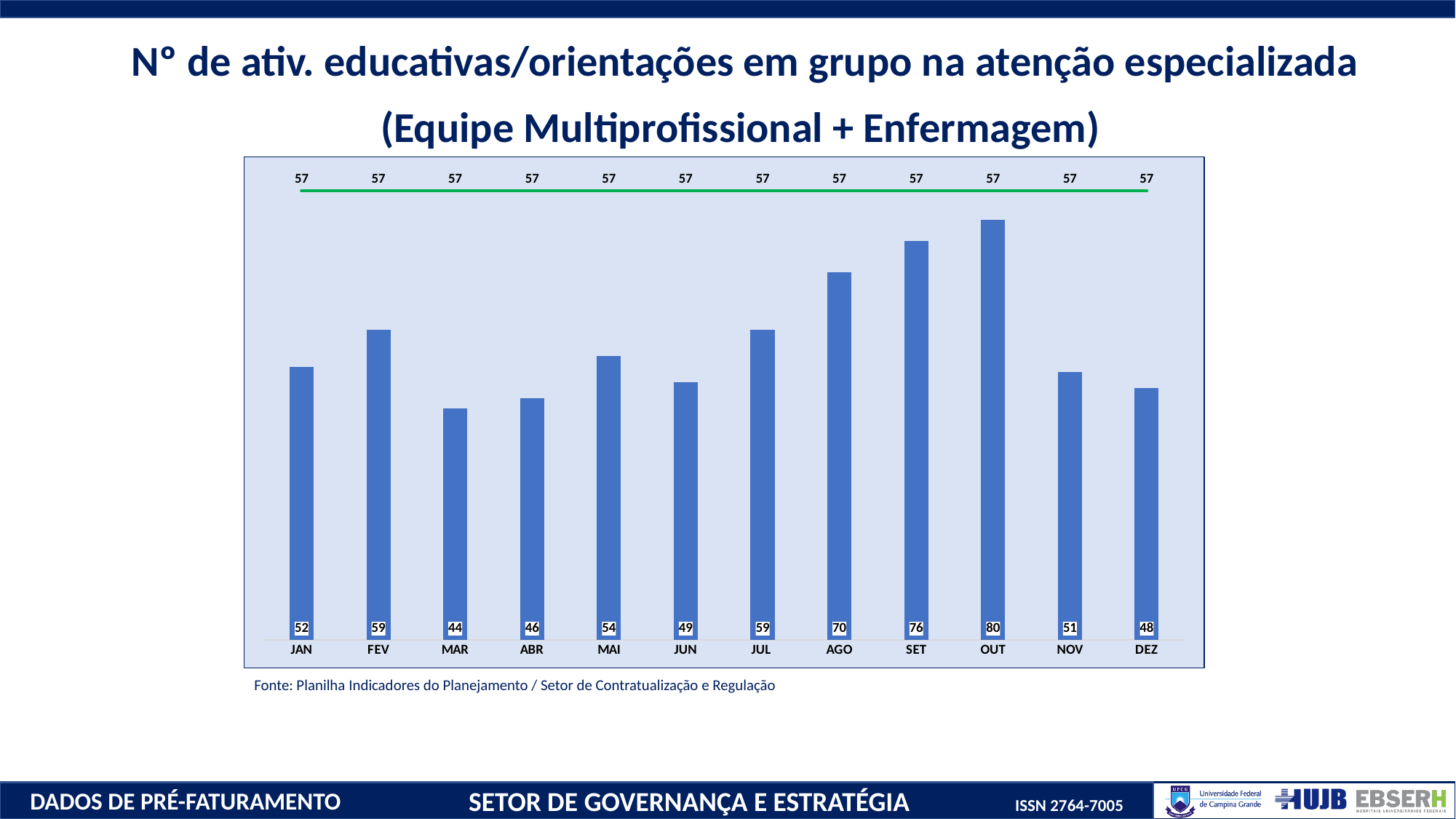
What is the value of the bar for AGO? 70 What is the value of the bar for OUT? 80 What kind of chart is shown on the slide? bar chart How many months are shown on the x axis? 12 Which is larger, the bar for MAI or the bar for JUN? MAI What is the value of the bar for MAR? 44 Which month has the highest bar? OUT What is the difference between the bar values for JAN and DEZ? 4 Which month has the lowest bar? MAR Do the bar values rise or fall from JUN to OUT? rise What constant value does the green line show across all months? 57 What is the difference between the bar values for OUT and SET? 4